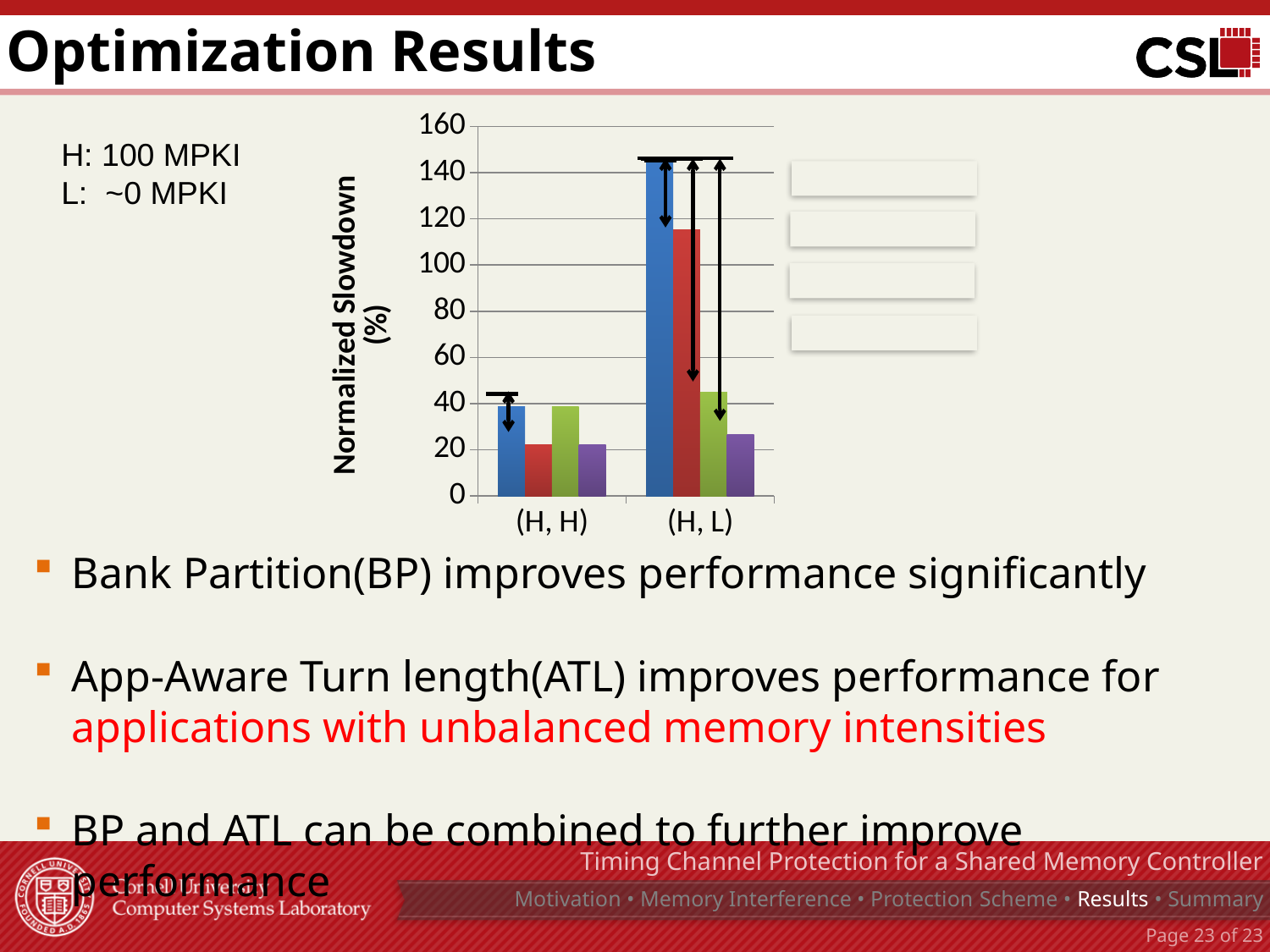
How many bars are plotted for each category in the chart? 4 Which bar is the tallest within the (H, L) category? the blue bar Which category contains the tallest bar in the chart? (H, L) Is the value of the green bar for (H, L) greater or less than 60? less What is the title of the vertical axis of the chart? Normalized Slowdown (%) Which bar is the shortest within the (H, L) category? the purple bar What is the highest tick value shown on the vertical axis of the chart? 160 What kind of chart is shown on the slide? bar chart Is the value of the blue bar for (H, L) greater or less than 120? greater How many categories are shown on the x axis of the chart? 2 Which is larger, the blue bar for (H, H) or the blue bar for (H, L)? the blue bar for (H, L) Is the value of the red bar for (H, L) greater or less than 100? greater